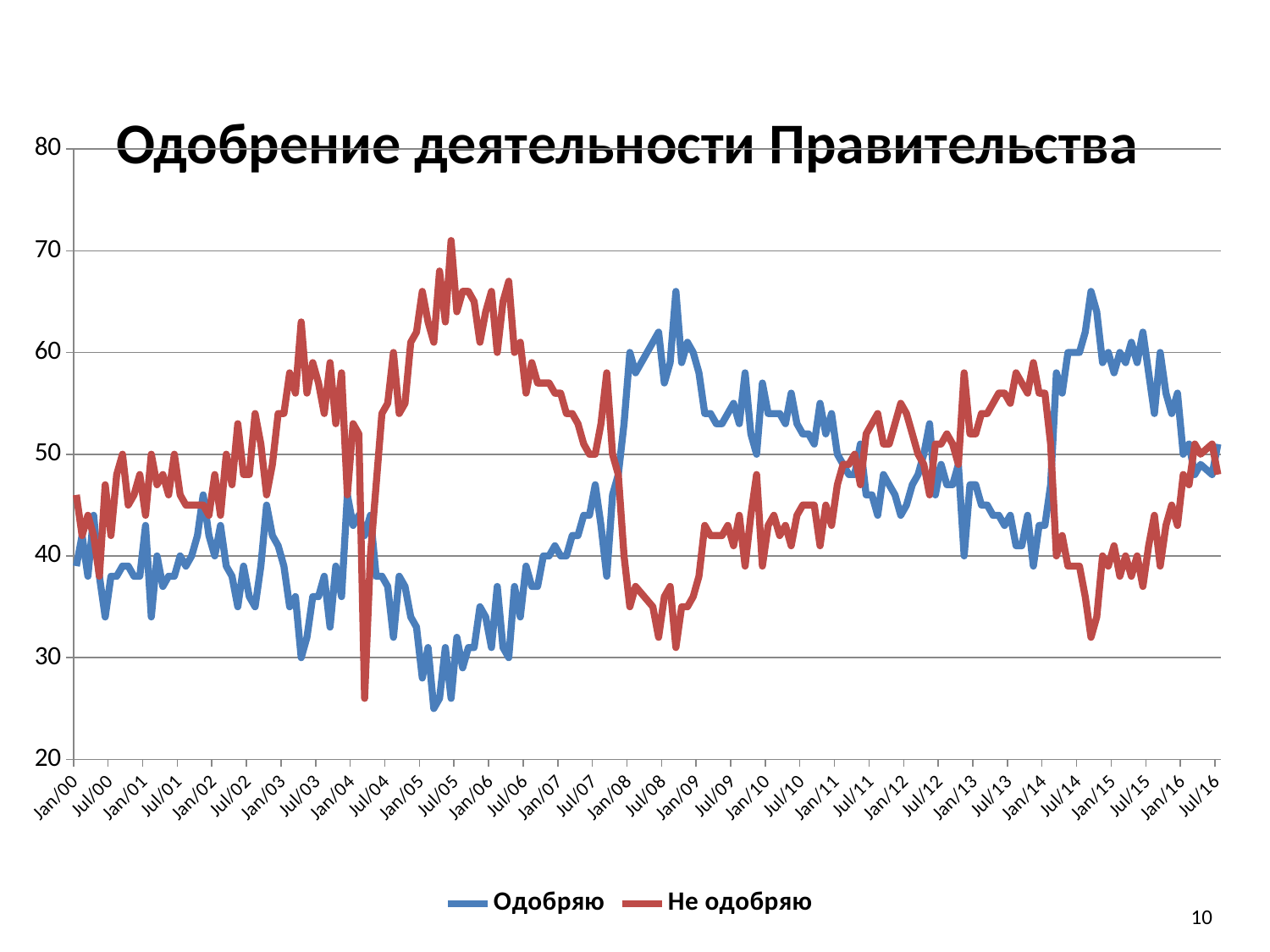
Is the value of Не одобряю at Jul/05 greater or less than 60? greater What kind of chart is shown on the slide? line chart Is the value of Одобряю at Jan/05 greater or less than 40? less At Jul/05, which series has the higher value, Одобряю or Не одобряю? Не одобряю Does the Не одобряю line rise or fall between Jul/05 and Jan/08? fall Is the value of Не одобряю at Jan/15 greater or less than 50? less At Jul/08, which series has the higher value, Одобряю or Не одобряю? Одобряю How many series does the legend list? 2 Does the Одобряю line rise or fall between Jan/05 and Jan/08? rise Which series is drawn in red? Не одобряю What is the title of the chart? Одобрение деятельности Правительства